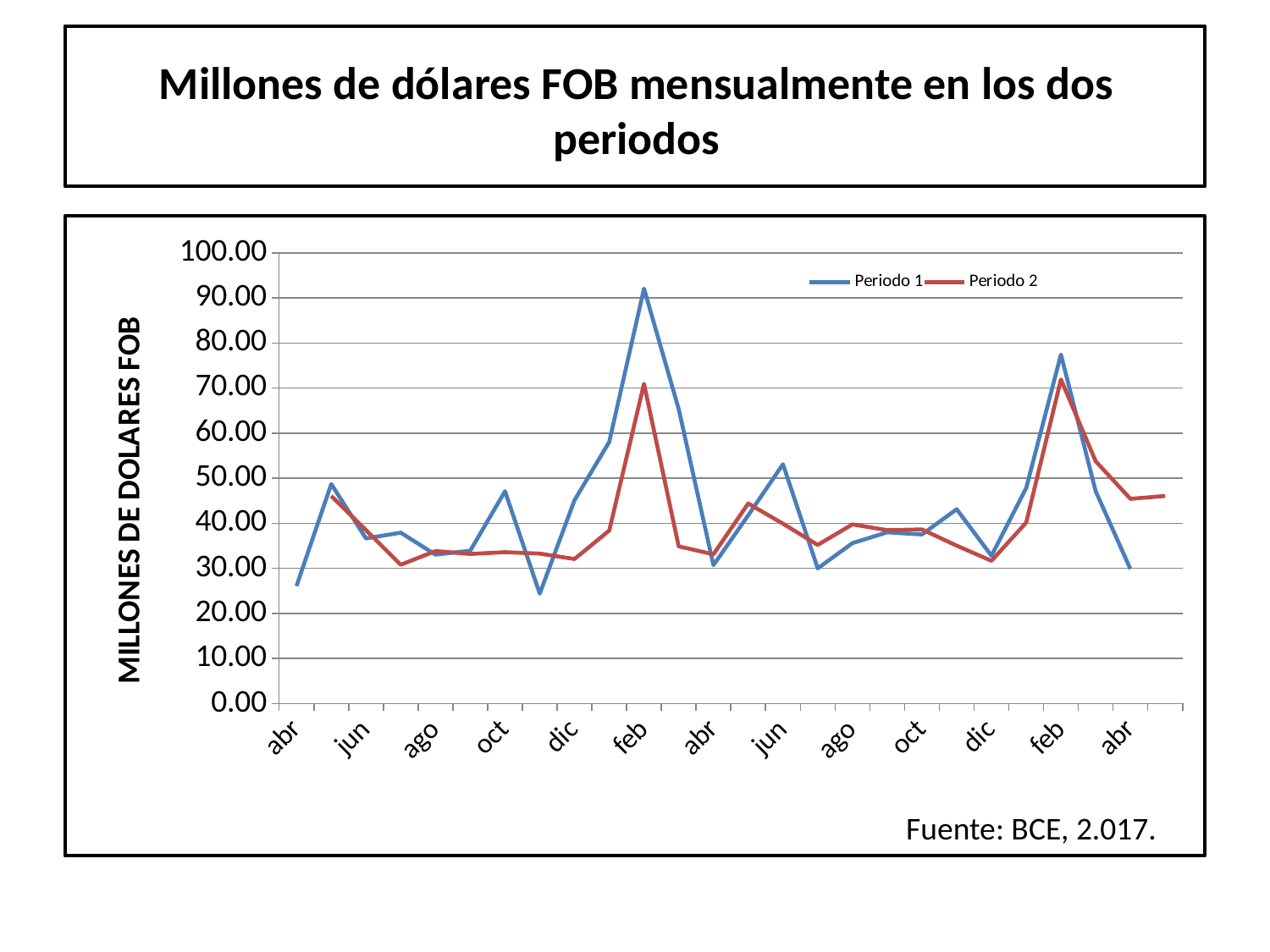
Is the value for Periodo 2 at the first feb greater or less than 60.00? greater At which x-axis label does Periodo 1 reach its highest value? the first feb Is the value for Periodo 2 at the last abr greater or less than 40.00? greater Is the value for Periodo 1 at the first dic greater or less than 30.00? greater At the last abr, which series has the larger value, Periodo 1 or Periodo 2? Periodo 2 At the first feb, which series has the larger value, Periodo 1 or Periodo 2? Periodo 1 What is the title of the y axis? MILLONES DE DOLARES FOB What are the names of the two series in the legend? Periodo 1 and Periodo 2 How many series does the legend list? 2 What kind of chart is shown on the slide? line chart